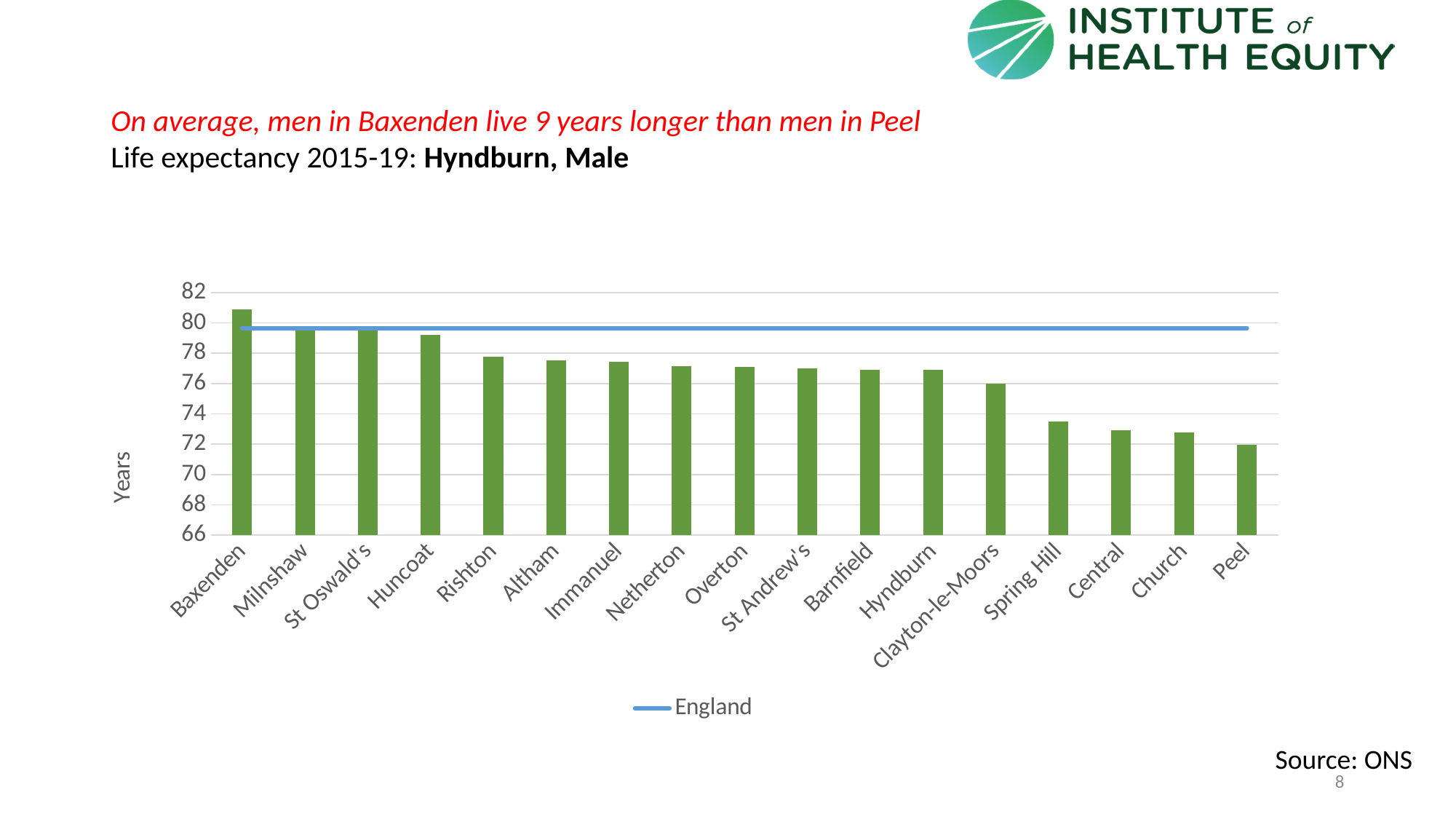
Which area has the highest male life expectancy in the chart? Baxenden What kind of chart is shown on the slide? Combination bar and line chart (bars with a horizontal England line) Do the bar values rise or fall moving from left to right along the x axis? Fall Is the value for Central greater or less than 74? less Is the value for Huncoat greater or less than 78? greater Which area has the lowest male life expectancy in the chart? Peel How many areas (bars) are plotted in the chart? 17 How many series does the legend list? 1 What does the horizontal blue line in the chart represent, according to the legend? England Is the value for Peel greater or less than 74? less Which is larger, the value for Huncoat or the value for Spring Hill? Huncoat